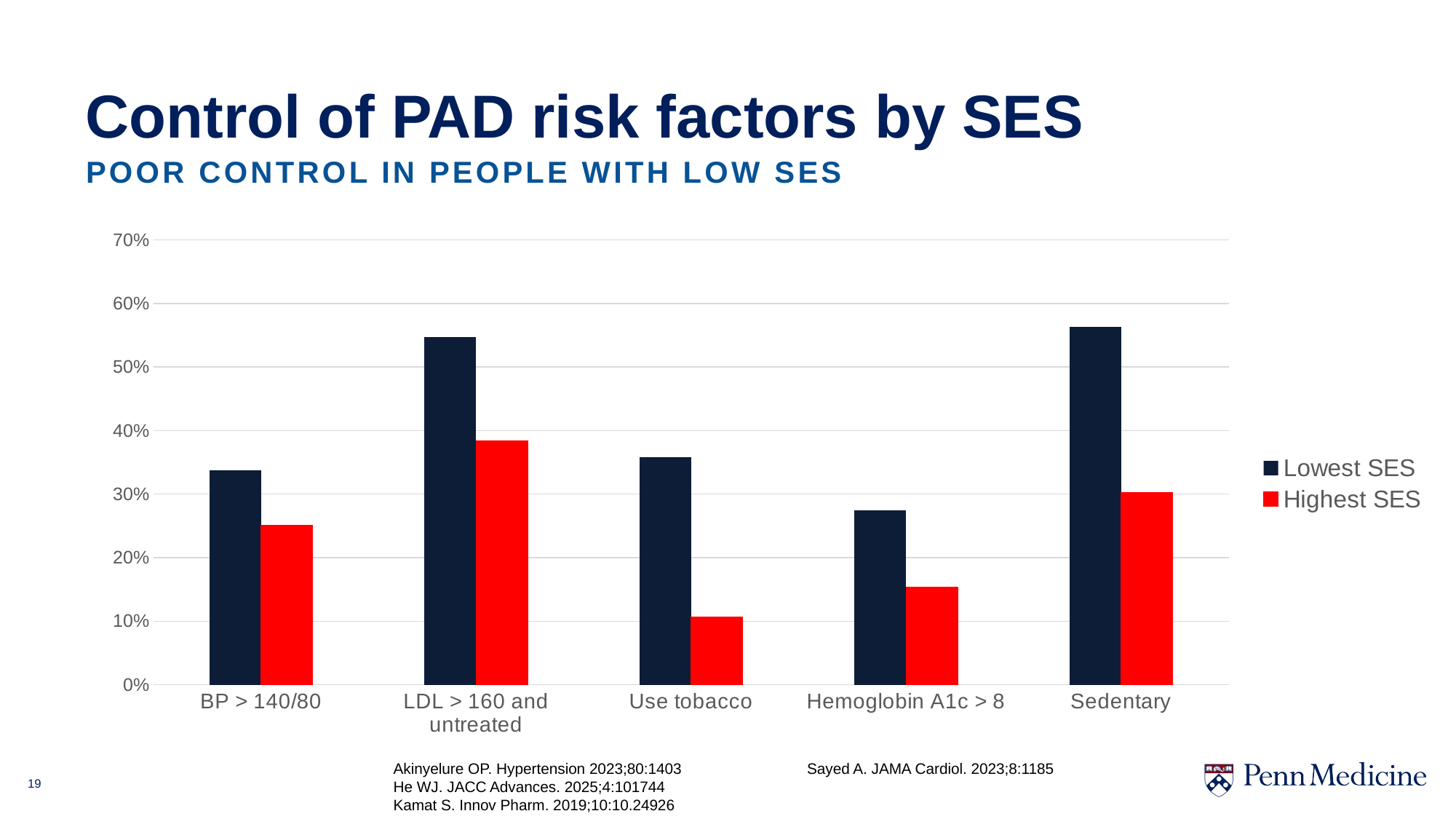
Is the Lowest SES value for Sedentary greater or less than 50%? greater What colour are the bars for the Highest SES series? red Which category has the lowest value for the Highest SES series? Use tobacco For Use tobacco, which series has the larger value, Lowest SES or Highest SES? Lowest SES How many series does the legend list? 2 Is the Lowest SES value for LDL > 160 and untreated greater or less than 50%? greater Is the Highest SES value for Hemoglobin A1c > 8 greater or less than 20%? less What kind of chart is shown on the slide? bar chart Which category has the highest value for the Highest SES series? LDL > 160 and untreated How many risk factor categories are shown on the x axis? 5 Which category has the lowest value for the Lowest SES series? Hemoglobin A1c > 8